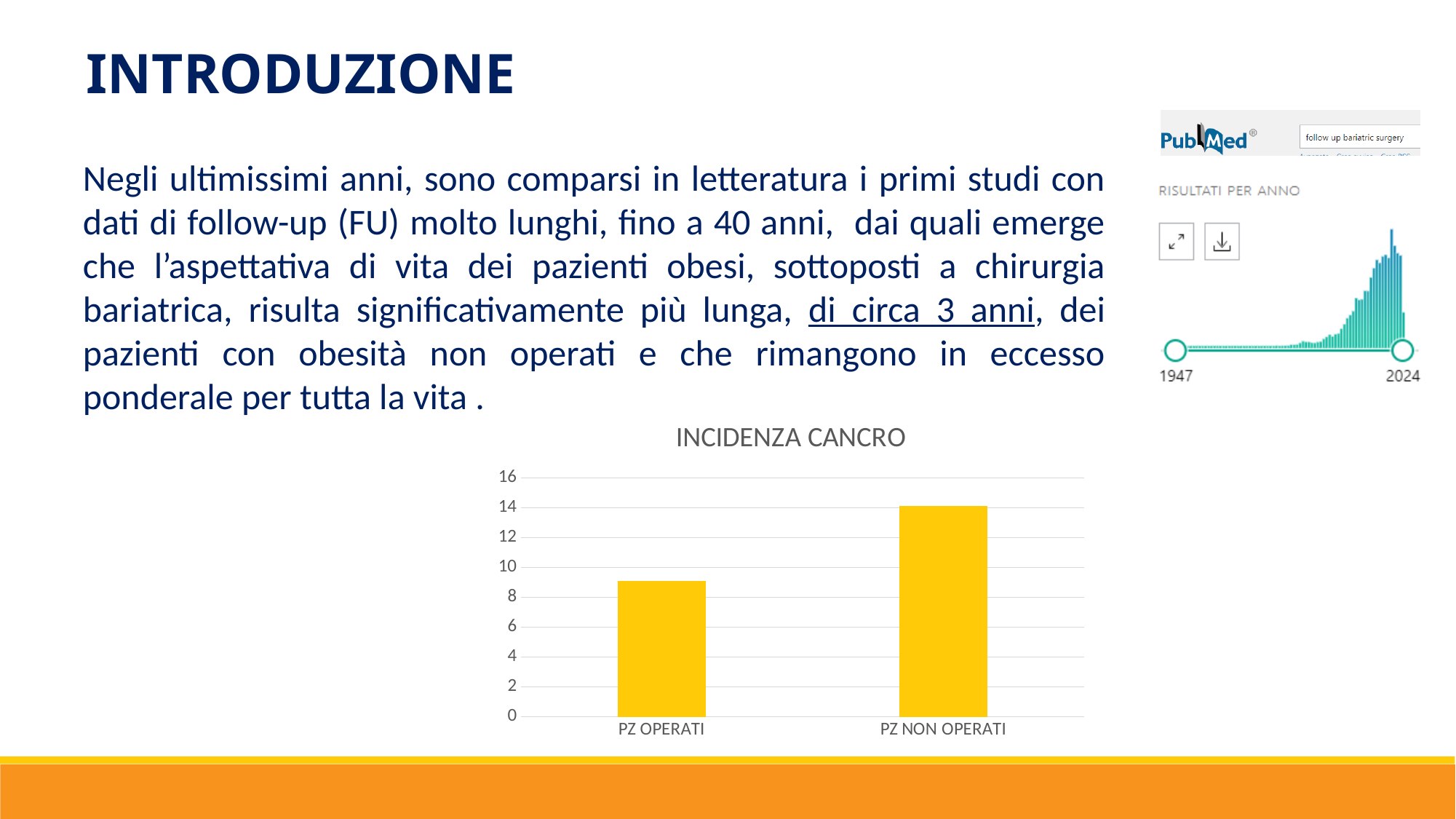
In the INCIDENZA CANCRO chart, is the value for PZ OPERATI greater or less than 8? greater In the INCIDENZA CANCRO chart, which category has the lowest value? PZ OPERATI How many categories are shown on the x axis of the INCIDENZA CANCRO chart? 2 What colour are the bars in the INCIDENZA CANCRO chart? yellow What is the maximum value shown on the y axis of the INCIDENZA CANCRO chart? 16 In the INCIDENZA CANCRO chart, which is larger: the value for PZ OPERATI or the value for PZ NON OPERATI? PZ NON OPERATI What type of chart is the INCIDENZA CANCRO chart? bar chart In the INCIDENZA CANCRO chart, is the value for PZ OPERATI greater or less than 10? less What is the title of the bar chart at the bottom of the slide? INCIDENZA CANCRO In the INCIDENZA CANCRO chart, is the value for PZ NON OPERATI greater or less than 16? less In the INCIDENZA CANCRO chart, which category has the highest value? PZ NON OPERATI